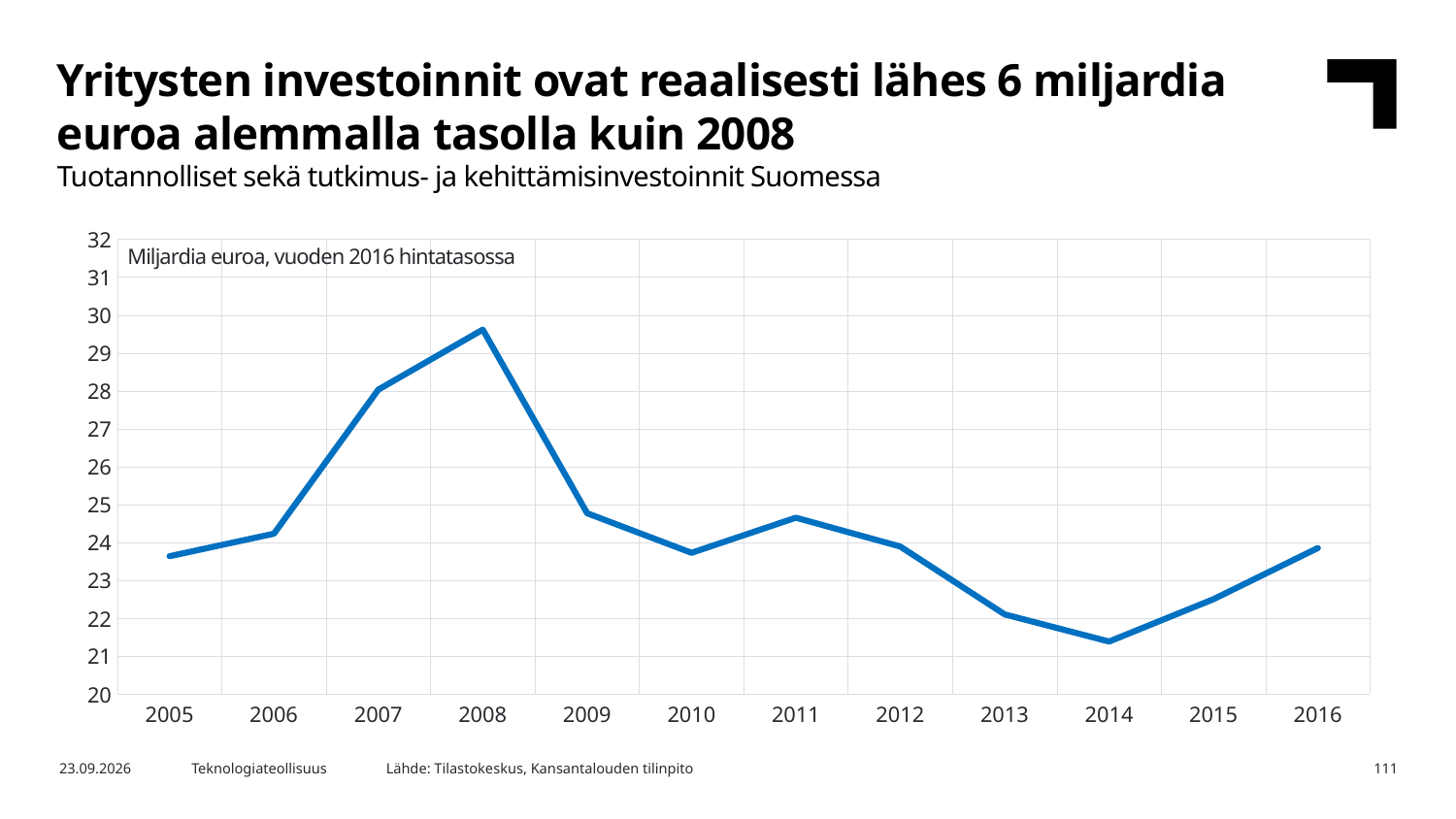
What unit is stated in the label inside the chart area? Miljardia euroa, vuoden 2016 hintatasossa In which year is the value of investments lowest? 2014 What kind of chart is shown on the slide? line chart Is the value for 2013 greater or less than 23? less Which year has a larger value, 2011 or 2013? 2011 Is the value for 2008 greater or less than 29? greater Is the value for 2007 greater or less than 27? greater In which year is the value of investments highest? 2008 Which year has a larger value, 2007 or 2009? 2007 How many years are plotted on the x axis of the chart? 12 Do the values rise or fall between 2008 and 2010? fall